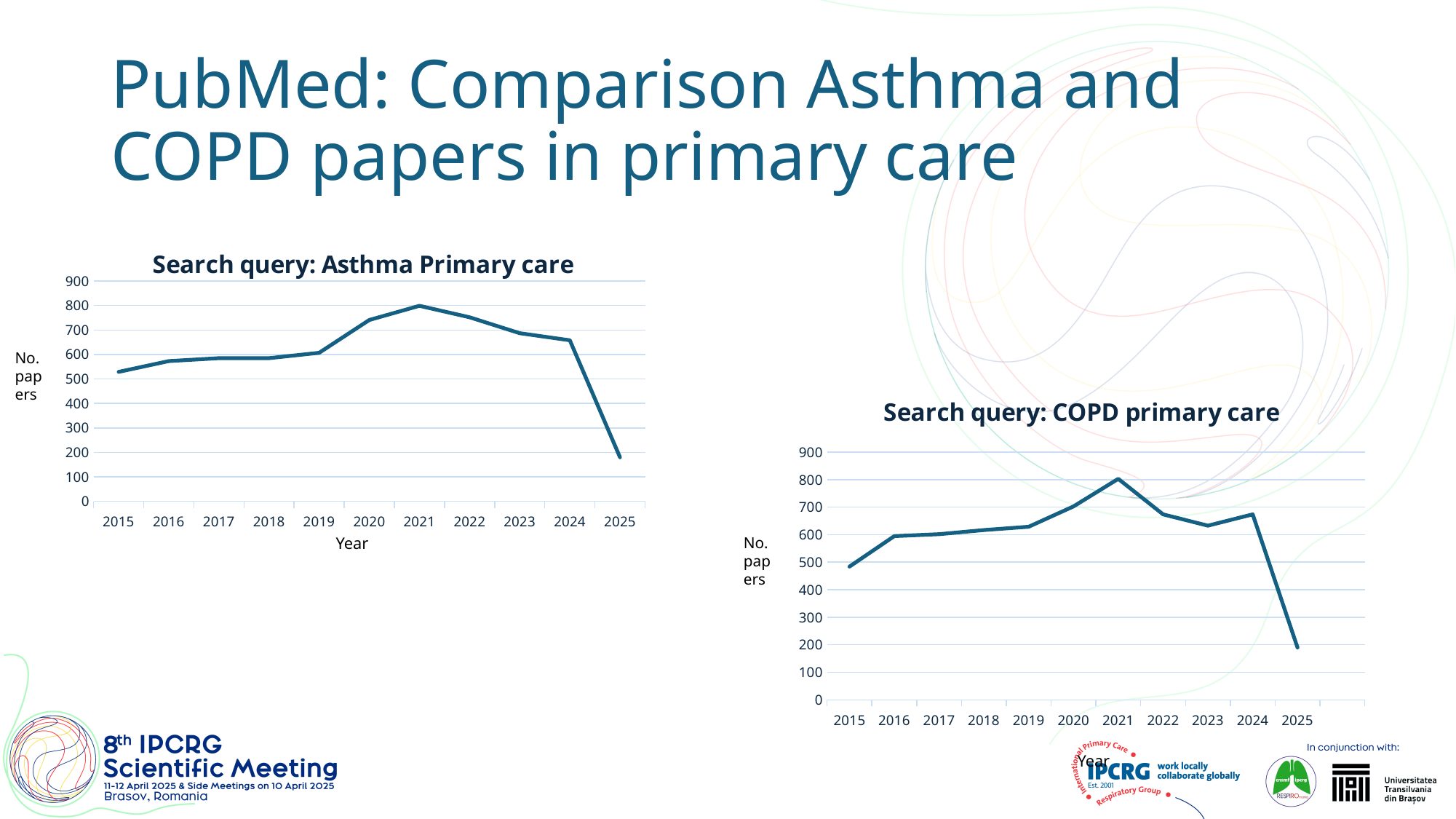
In the 'Search query: Asthma Primary care' chart, which year has the lowest number of papers? 2025 In the 'Search query: Asthma Primary care' chart, is the value for 2020 greater or less than 700? greater In the 'Search query: COPD primary care' chart, which year has the lowest number of papers? 2025 How many years are plotted on the x axis of the 'Search query: COPD primary care' chart? 11 In the 'Search query: COPD primary care' chart, which year has the highest number of papers? 2021 What kind of chart is the 'Search query: Asthma Primary care' chart? line chart In the 'Search query: Asthma Primary care' chart, is the value for 2025 greater or less than 300? less In the 'Search query: Asthma Primary care' chart, which year has the highest number of papers? 2021 In the 'Search query: COPD primary care' chart, which year has the larger value, 2016 or 2021? 2021 What is the label on the y axis of the 'Search query: COPD primary care' chart? No. papers In the 'Search query: Asthma Primary care' chart, do the values rise or fall from 2021 to 2025? fall